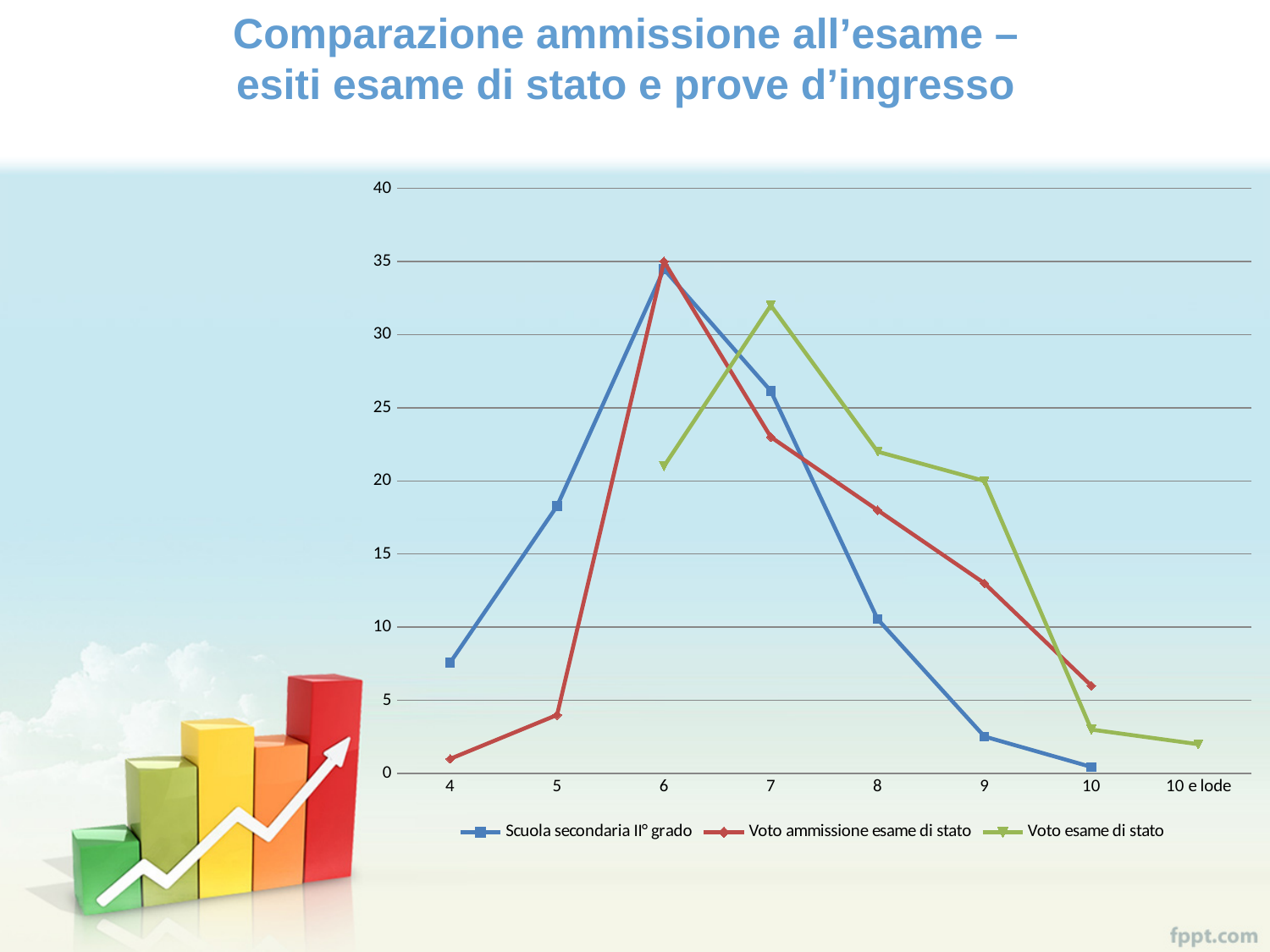
What is the label of the last category on the x axis? 10 e lode Is the value for 'Scuola secondaria II° grado' at category 5 greater or less than 15? greater How many series does the legend list? 3 Is the value for 'Voto ammissione esame di stato' at category 7 greater or less than 25? less At which x-axis category does the 'Voto esame di stato' series reach its highest value? 7 At which x-axis category is the 'Voto ammissione esame di stato' series lowest? 4 What kind of chart is shown on the slide? line chart How many categories are shown on the x axis? 8 At which x-axis category does the 'Scuola secondaria II° grado' series reach its highest value? 6 Does the 'Scuola secondaria II° grado' series rise or fall from category 6 to category 10? fall At category 7, which series has the larger value: 'Voto esame di stato' or 'Scuola secondaria II° grado'? Voto esame di stato Is the value for 'Voto esame di stato' at category 10 greater or less than 5? less